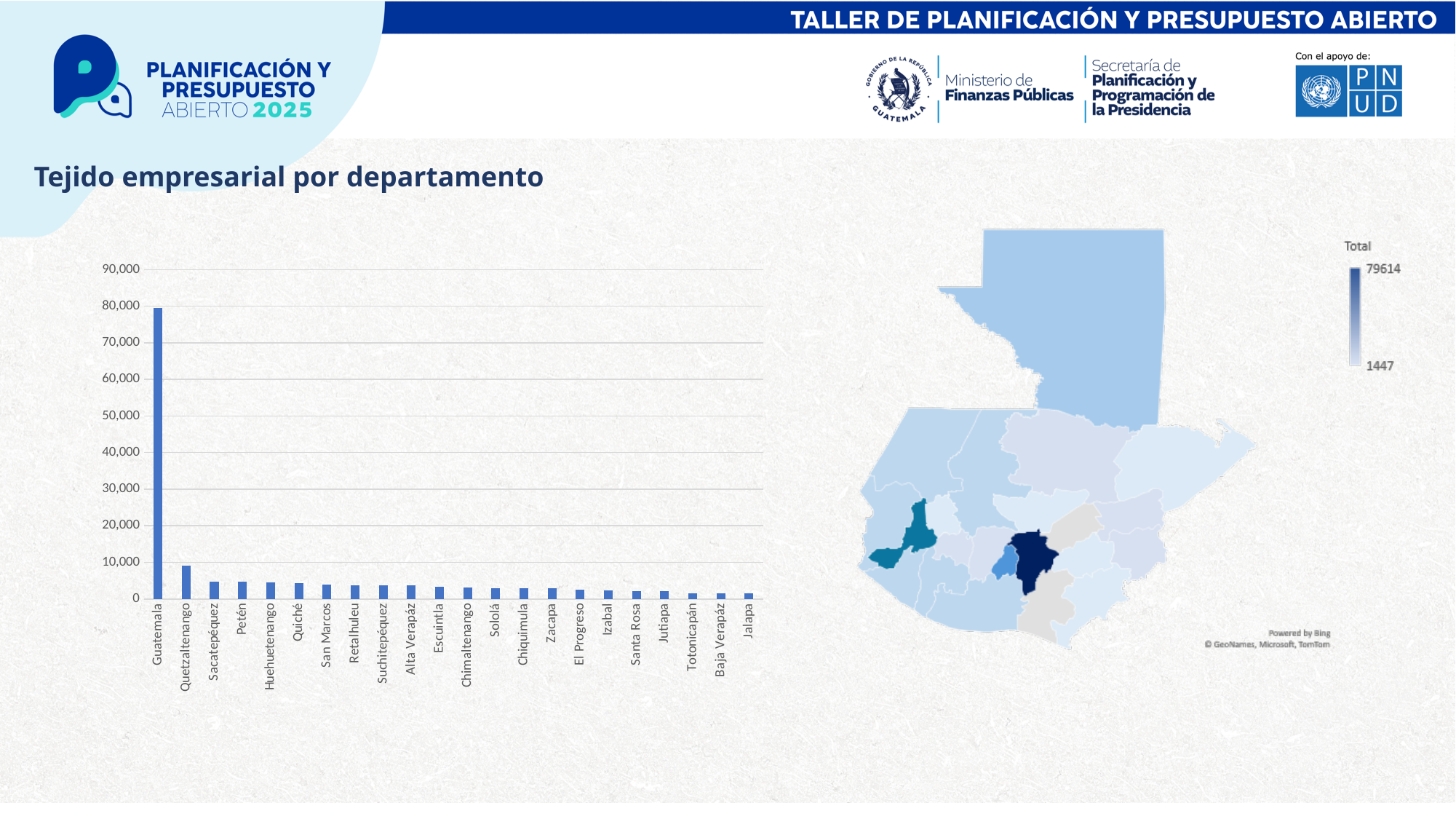
In the bar chart, which department has the highest value? Guatemala In the bar chart, which is larger, the value for Guatemala or the value for Quetzaltenango? Guatemala What is the title of the slide's chart section? Tejido empresarial por departamento In the bar chart, is the value for Petén greater or less than 10,000? less How many departments are shown on the x axis of the bar chart? 22 In the bar chart, which is larger, the value for Quetzaltenango or the value for Sacatepéquez? Quetzaltenango What is the maximum value shown on the map's Total legend? 79614 In the bar chart, is the value for Quetzaltenango greater or less than 10,000? less Do the values in the bar chart rise or fall moving from left to right along the x axis? fall What kind of chart is shown on the left of the slide? bar chart In the bar chart, is the value for Guatemala greater or less than 70,000? greater